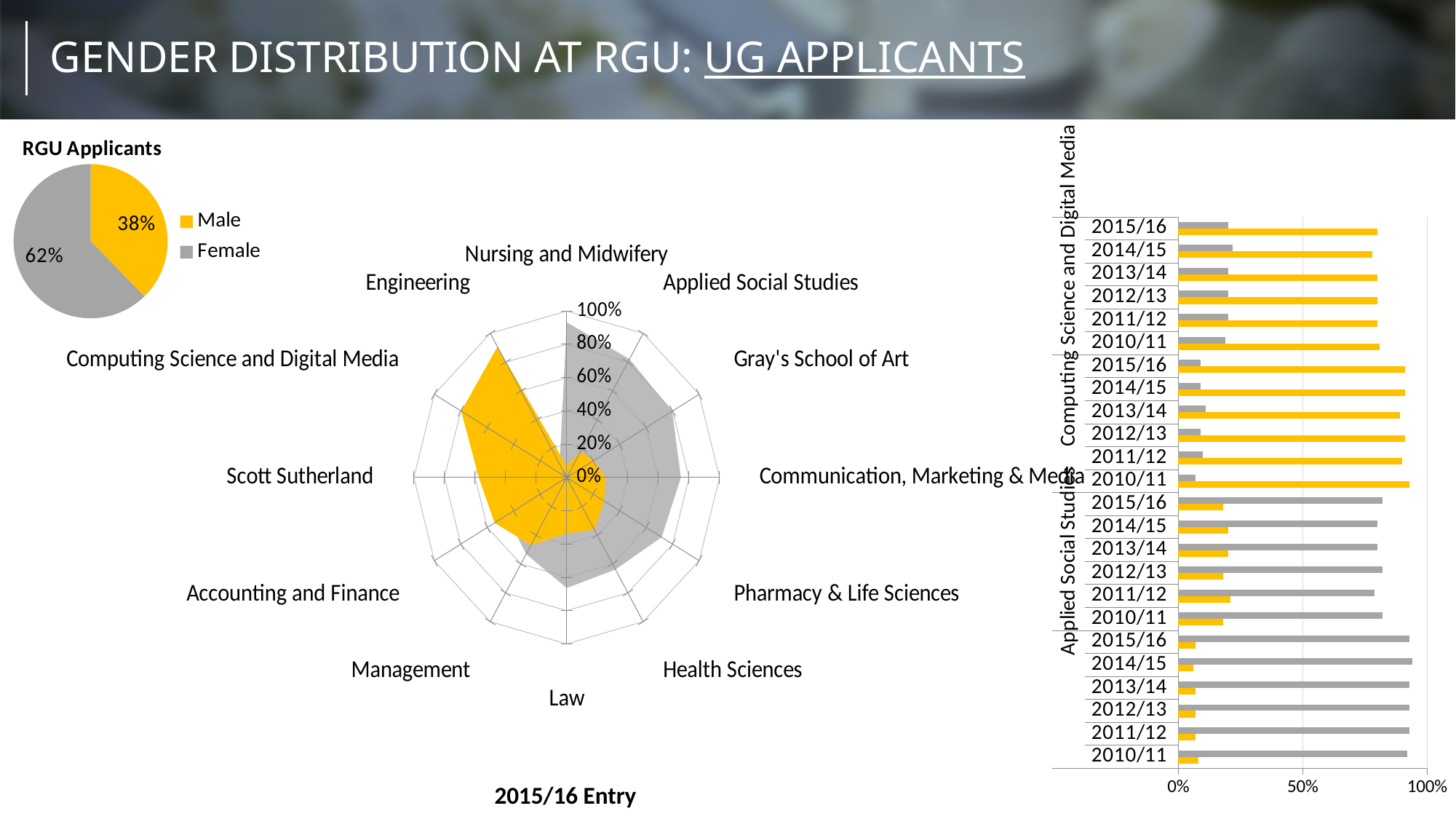
What kind of chart is the RGU Applicants chart on the left of the slide? Pie chart In the RGU Applicants pie chart, what percentage of applicants are Male? 38% What kind of chart is the 2015/16 Entry chart in the centre of the slide? Radar chart How many schools (categories) are shown on the 2015/16 Entry radar chart? 12 What is the highest value shown on the axis of the 2015/16 Entry radar chart? 100% In the RGU Applicants pie chart, which slice is larger, Male or Female? Female In the 2015/16 Entry radar chart, is the Male value for Computing Science and Digital Media greater or less than 60%? greater How many entries does the legend of the RGU Applicants pie chart list? 2 In the RGU Applicants pie chart, what percentage of applicants are Female? 62% What kind of chart is the chart on the right of the slide showing years from 2010/11 to 2015/16? Bar chart In the 2015/16 Entry radar chart, is the Male value for Nursing and Midwifery greater or less than 20%? less In the RGU Applicants pie chart, what is the difference in percentage points between the Female and Male shares? 24 percentage points